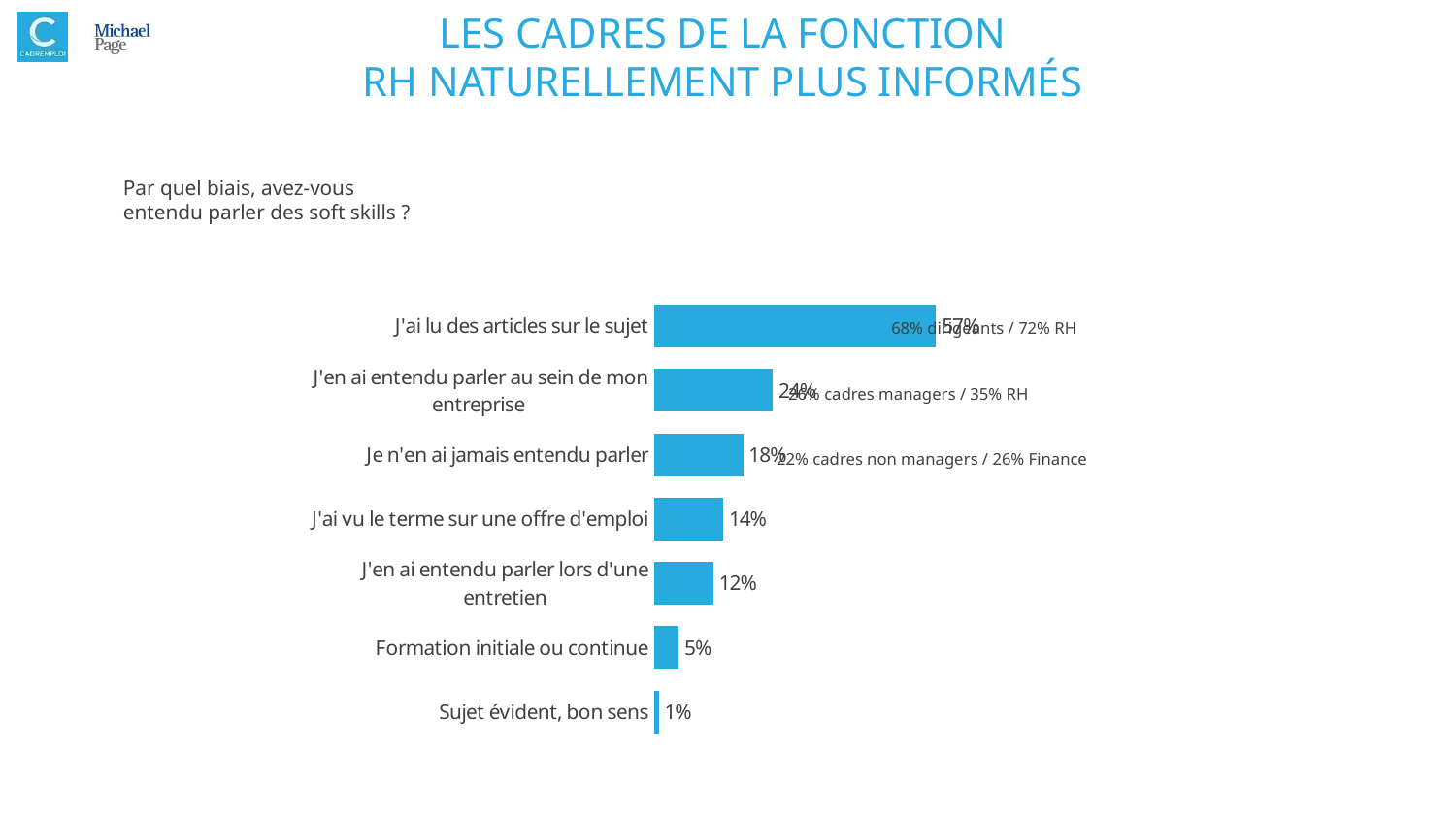
What kind of chart is shown on the slide? bar chart What is the value for "J'ai vu le terme sur une offre d'emploi"? 14% What is the difference between "J'ai lu des articles sur le sujet" and "Je n'en ai jamais entendu parler"? 39% What is the value for "Je n'en ai jamais entendu parler"? 18% Which category has the lowest value? Sujet évident, bon sens How many categories does the bar chart show? 7 Which is larger: "Formation initiale ou continue" or "J'en ai entendu parler lors d'une entretien"? J'en ai entendu parler lors d'une entretien Which category has the highest value? J'ai lu des articles sur le sujet What is the value for "J'ai lu des articles sur le sujet"? 57% What survey question does the chart answer, as written on the slide? Par quel biais, avez-vous entendu parler des soft skills ? What is the value for "Formation initiale ou continue"? 5% What is the difference between "J'ai vu le terme sur une offre d'emploi" and "J'en ai entendu parler lors d'une entretien"? 2%